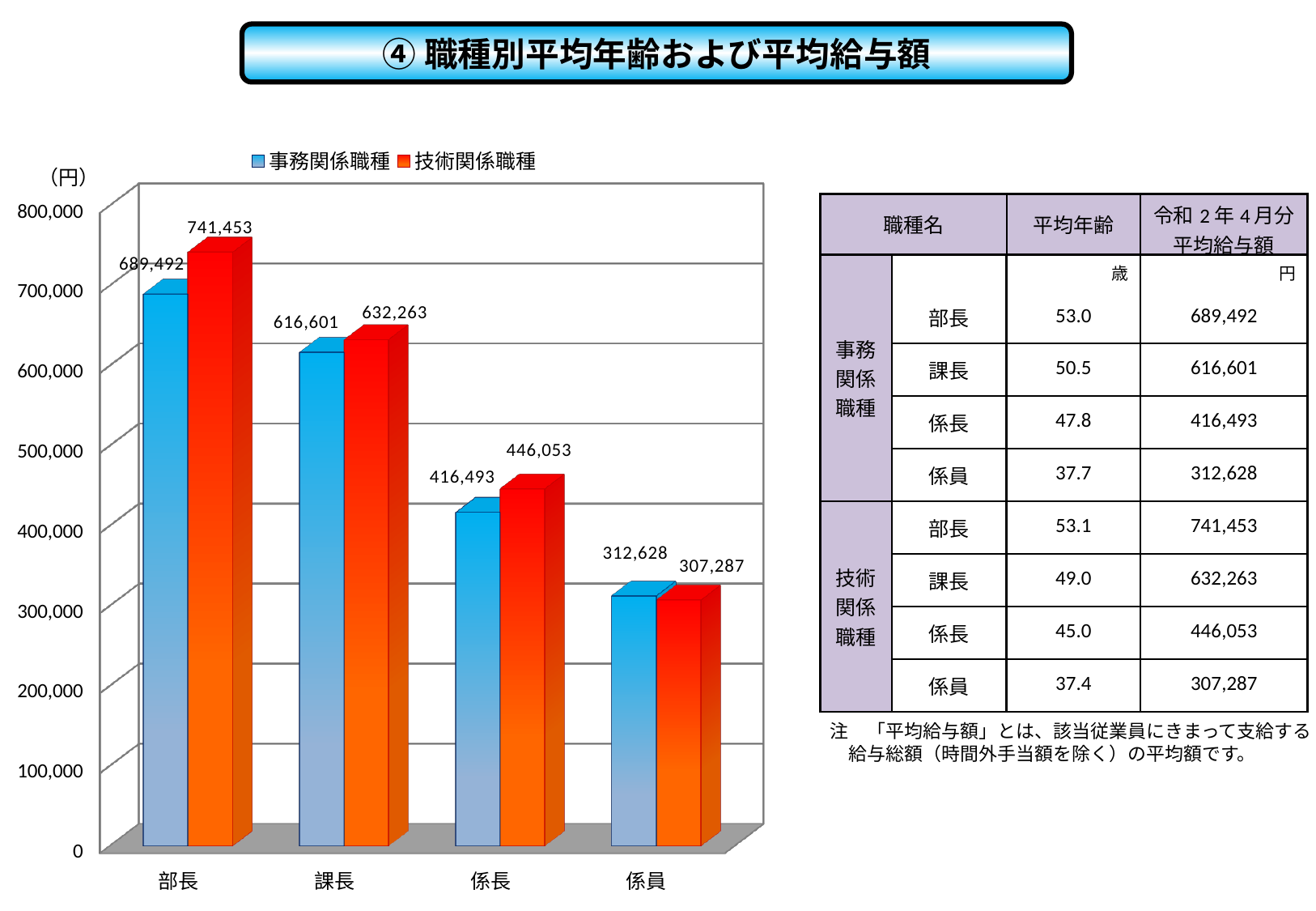
What is the value for 係員 in the 事務関係職種 series? 312,628 How many series does the chart legend list? 2 What kind of chart is shown on the slide? Bar chart What is the difference between the 技術関係職種 and 事務関係職種 values for 部長? 51,961 Which category has the lowest value in the 事務関係職種 series? 係員 For 係員, which series has the larger value, 事務関係職種 or 技術関係職種? 事務関係職種 Do the values in the 技術関係職種 series rise or fall from 部長 to 係員? Fall How many categories are shown on the x axis of the chart? 4 Which category has the highest value in the 技術関係職種 series? 部長 Is the value for 課長 in the 事務関係職種 series greater or less than 600,000? greater What is the value for 部長 in the 事務関係職種 series? 689,492 What is the value for 係長 in the 技術関係職種 series? 446,053